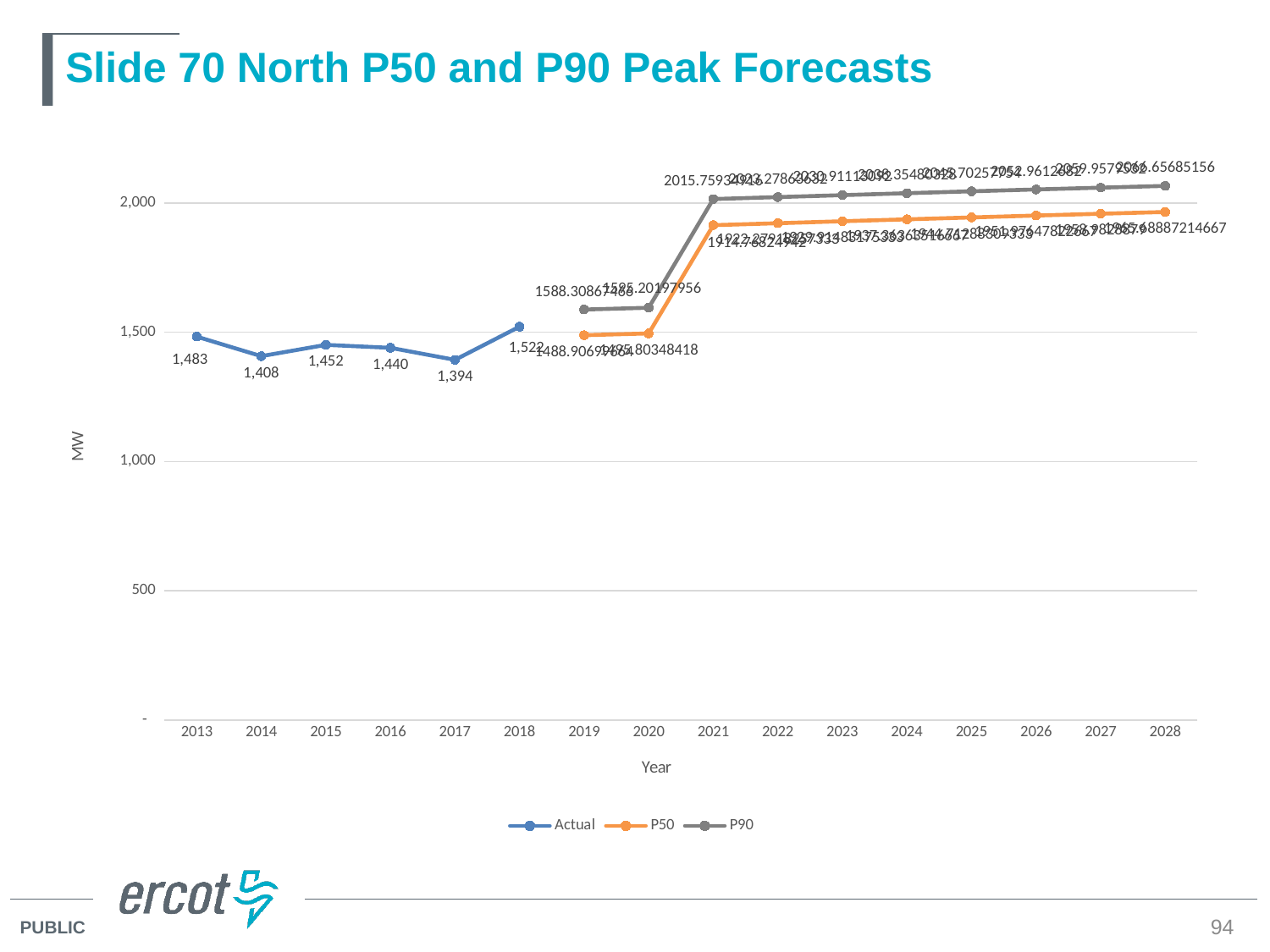
How many series does the legend list? 3 What is the Actual value for 2013? 1,483 Is the P90 value for 2028 greater or less than 2,000? greater What is the Actual value for 2018? 1,522 Which year has the highest Actual value? 2018 What kind of chart is shown on the slide? line chart What is the Actual value for 2017? 1,394 Is the P50 value for 2021 greater or less than 1,500? greater Which year has the lowest Actual value? 2017 Which year has the larger Actual value, 2015 or 2016? 2015 How many years are shown on the x axis? 16 What is the difference between the Actual values for 2018 and 2017? 128